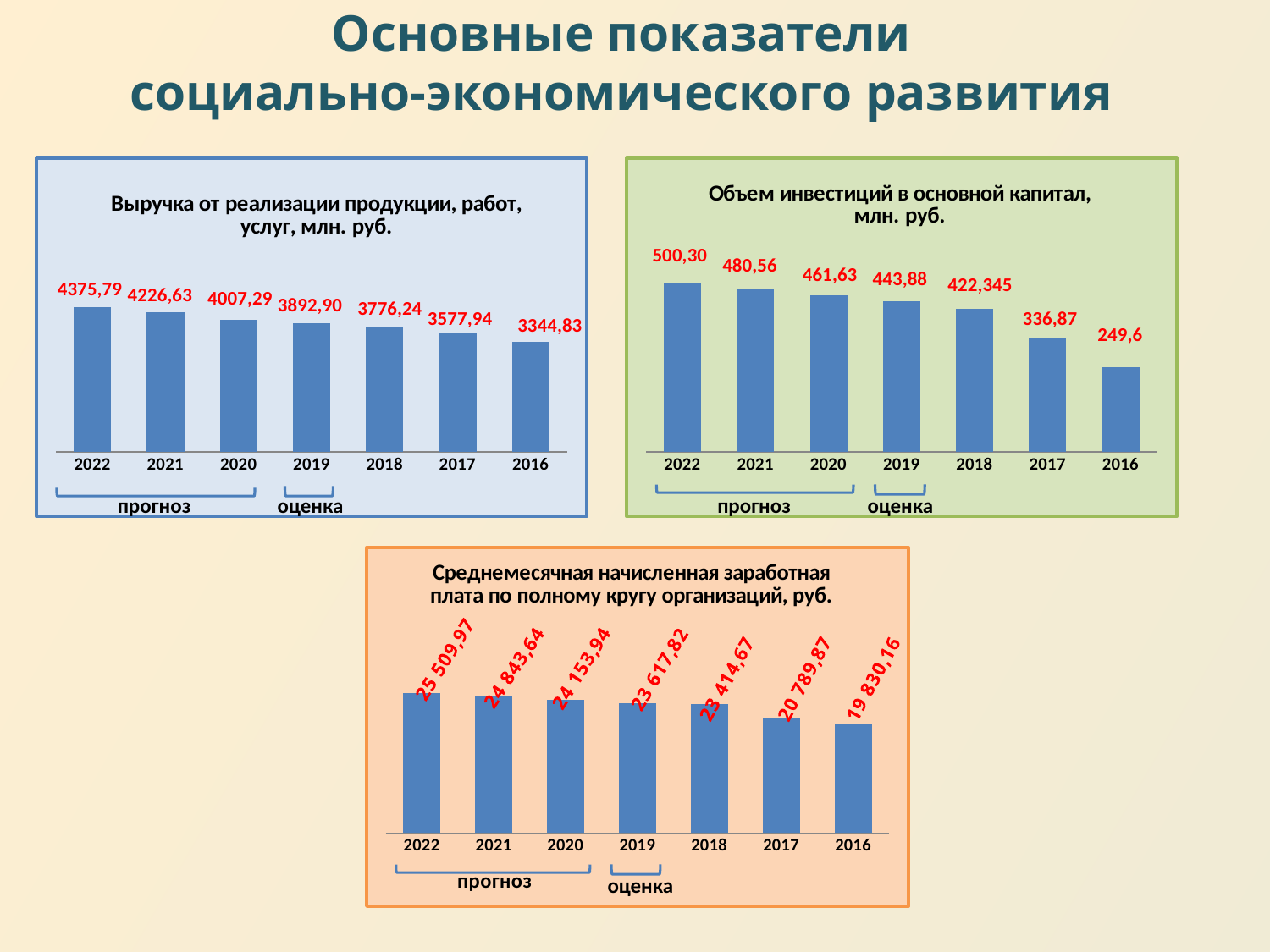
In the chart titled 'Среднемесячная начисленная заработная плата по полному кругу организаций, руб.', what is the difference between the values for 2017 and 2016? 959,71 In the chart titled 'Среднемесячная начисленная заработная плата по полному кругу организаций, руб.', what is the value for 2019? 23 617,82 What kind of chart is the one titled 'Выручка от реализации продукции, работ, услуг, млн. руб.'? bar chart In the chart titled 'Выручка от реализации продукции, работ, услуг, млн. руб.', which year has the lowest value? 2016 In the chart titled 'Среднемесячная начисленная заработная плата по полному кругу организаций, руб.', do the values rise or fall moving left to right along the x axis from 2022 to 2016? fall In the chart titled 'Объем инвестиций в основной капитал, млн. руб.', which is larger, the value for 2017 or the value for 2016? 2017 In the chart titled 'Среднемесячная начисленная заработная плата по полному кругу организаций, руб.', how many years are shown on the x axis? 7 In the chart titled 'Объем инвестиций в основной капитал, млн. руб.', which year has the highest value? 2022 In the chart titled 'Выручка от реализации продукции, работ, услуг, млн. руб.', what is the value for 2020? 4007,29 In the chart titled 'Объем инвестиций в основной капитал, млн. руб.', what is the value for 2018? 422,345 In the chart titled 'Выручка от реализации продукции, работ, услуг, млн. руб.', what is the difference between the values for 2022 and 2021? 149,16 In the chart titled 'Объем инвестиций в основной капитал, млн. руб.', what is the difference between the values for 2022 and 2016? 250,70